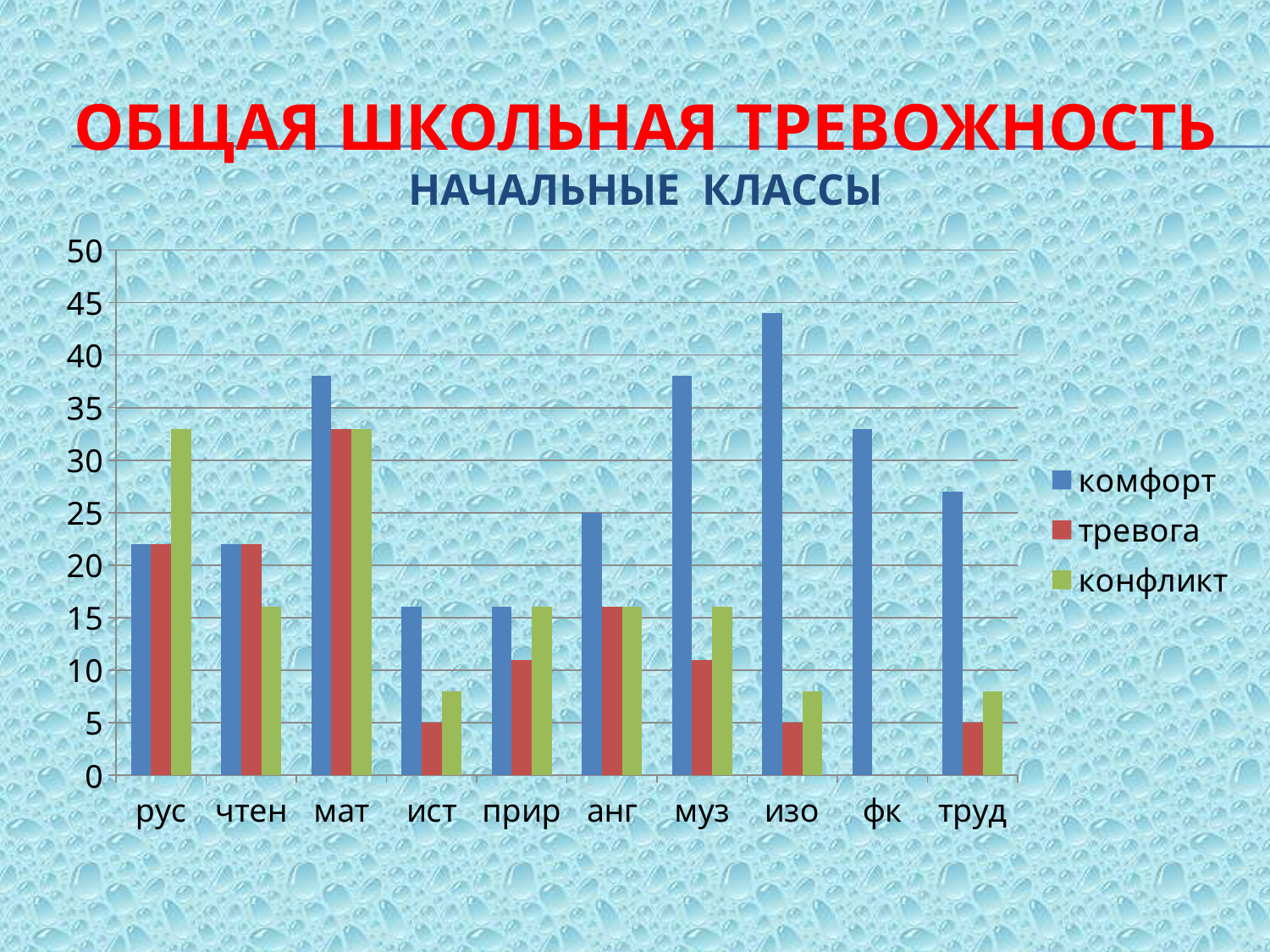
Is the value for комфорт in изо greater or less than 40? greater What are the three series listed in the legend? комфорт, тревога, конфликт How many categories are shown on the x axis? 10 Is the value for комфорт in труд greater or less than 25? greater How many series does the legend list? 3 Is the value for конфликт in рус greater or less than 30? greater In рус, which is larger: комфорт or конфликт? конфликт In мат, which is larger: комфорт or тревога? комфорт Which category has the highest value for комфорт? изо What kind of chart is shown on the slide? bar chart